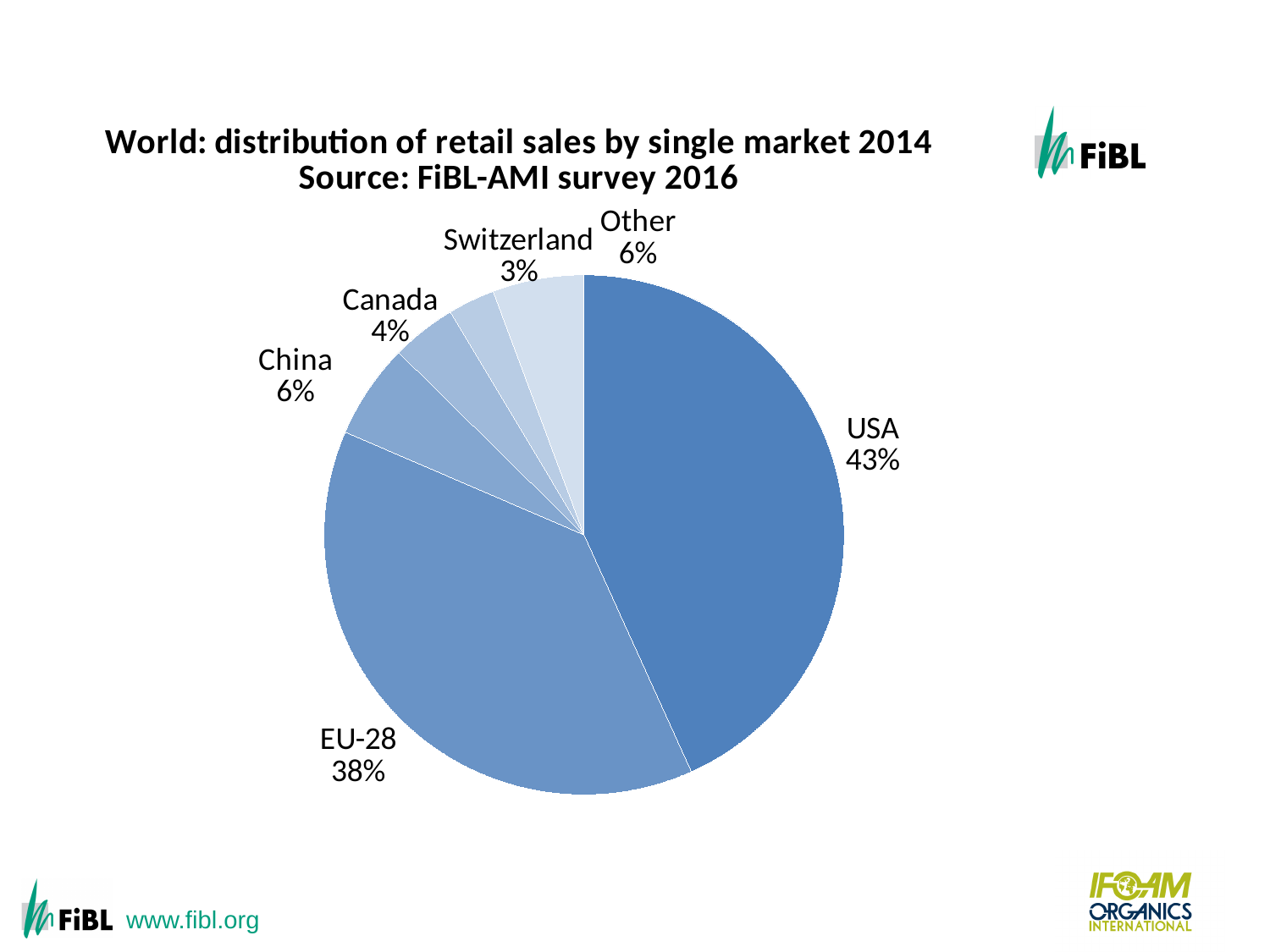
What kind of chart is shown on the slide? Pie chart What share of retail sales does Switzerland account for? 3% What share of retail sales does the USA account for? 43% Which has a larger share, Canada or China? China What share of retail sales does China account for? 6% How many slices does the pie chart have? 6 Which market has the smallest share of retail sales? Switzerland What share of retail sales does EU-28 account for? 38% What source is cited for the chart data? FiBL-AMI survey 2016 What is the title of the chart? World: distribution of retail sales by single market 2014 Which market has the largest share of retail sales? USA What is the difference in percentage points between the USA and EU-28 shares? 5